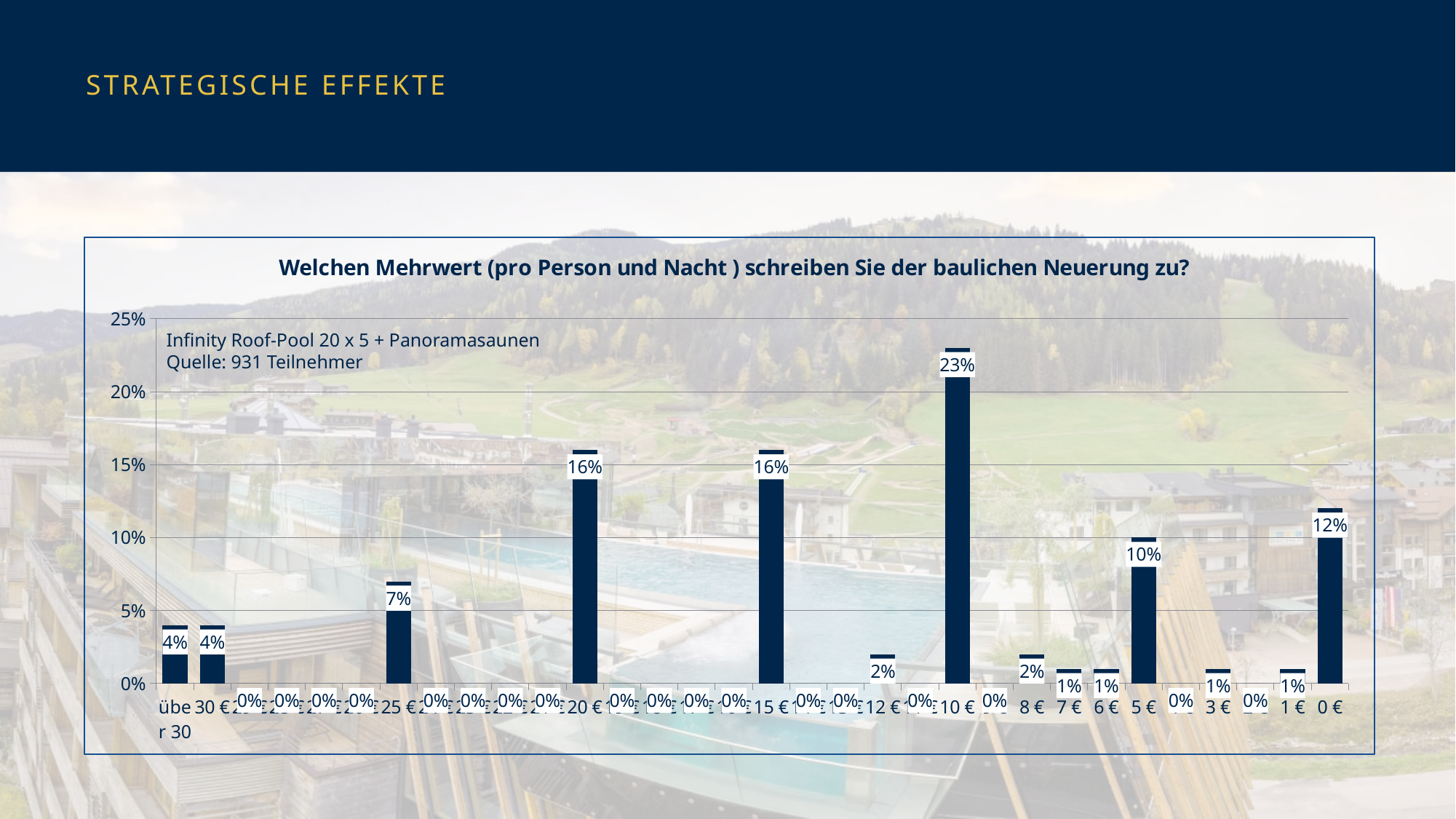
What is the value for 20 € in the chart? 16% Which category has the highest value in the chart? 10 € What is the value for 25 € in the chart? 7% What is the value for 10 € in the chart? 23% What is the value for 0 € in the chart? 12% What is the title of the chart? Welchen Mehrwert (pro Person und Nacht ) schreiben Sie der baulichen Neuerung zu? What kind of chart is shown on the slide? bar chart Is the value for 10 € greater or less than 20%? greater What is the difference between the values for 10 € and 0 €? 11% What is the value for 5 € in the chart? 10% Which is larger, the value for 0 € or the value for 5 €? 0 € What is the difference between the values for 5 € and 25 €? 3%